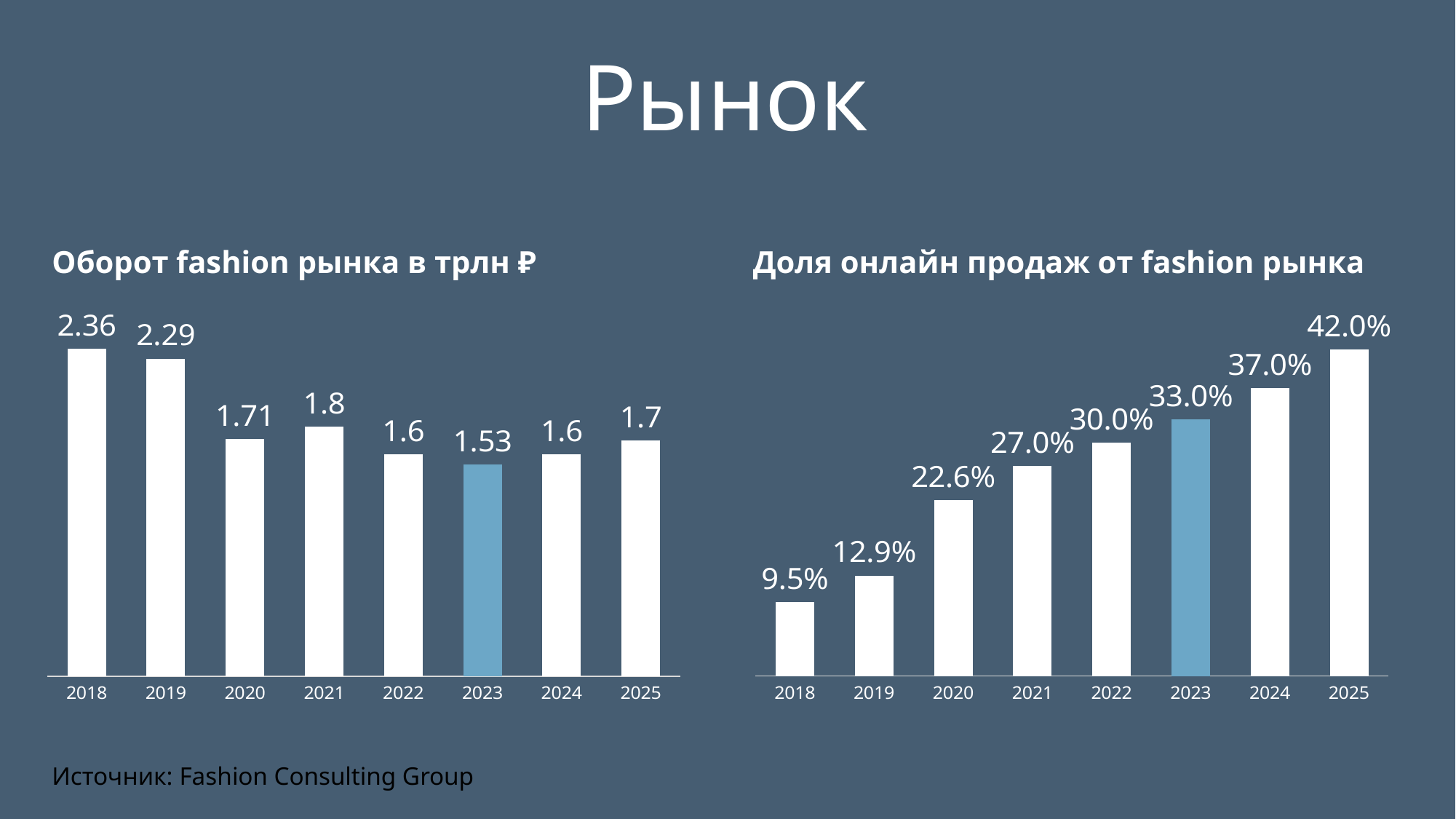
In the chart 'Доля онлайн продаж от fashion рынка', do the values rise or fall from 2018 to 2025? rise In the chart 'Оборот fashion рынка в трлн ₽', what is the value for 2023? 1.53 In the chart 'Доля онлайн продаж от fashion рынка', what is the value for 2025? 42.0% In the chart 'Оборот fashion рынка в трлн ₽', how many years are shown on the x axis? 8 In the chart 'Оборот fashion рынка в трлн ₽', which year has the highest value? 2018 In the chart 'Доля онлайн продаж от fashion рынка', which year has the lowest value? 2018 What kind of chart is 'Доля онлайн продаж от fashion рынка'? bar chart In the chart 'Оборот fashion рынка в трлн ₽', what is the difference between the values for 2018 and 2019? 0.07 In the chart 'Доля онлайн продаж от fashion рынка', what is the difference between the values for 2025 and 2024? 5.0% In the chart 'Оборот fashion рынка в трлн ₽', which year has the lowest value? 2023 In the chart 'Оборот fashion рынка в трлн ₽', what is the value for 2018? 2.36 In the chart 'Доля онлайн продаж от fashion рынка', what is the value for 2020? 22.6%